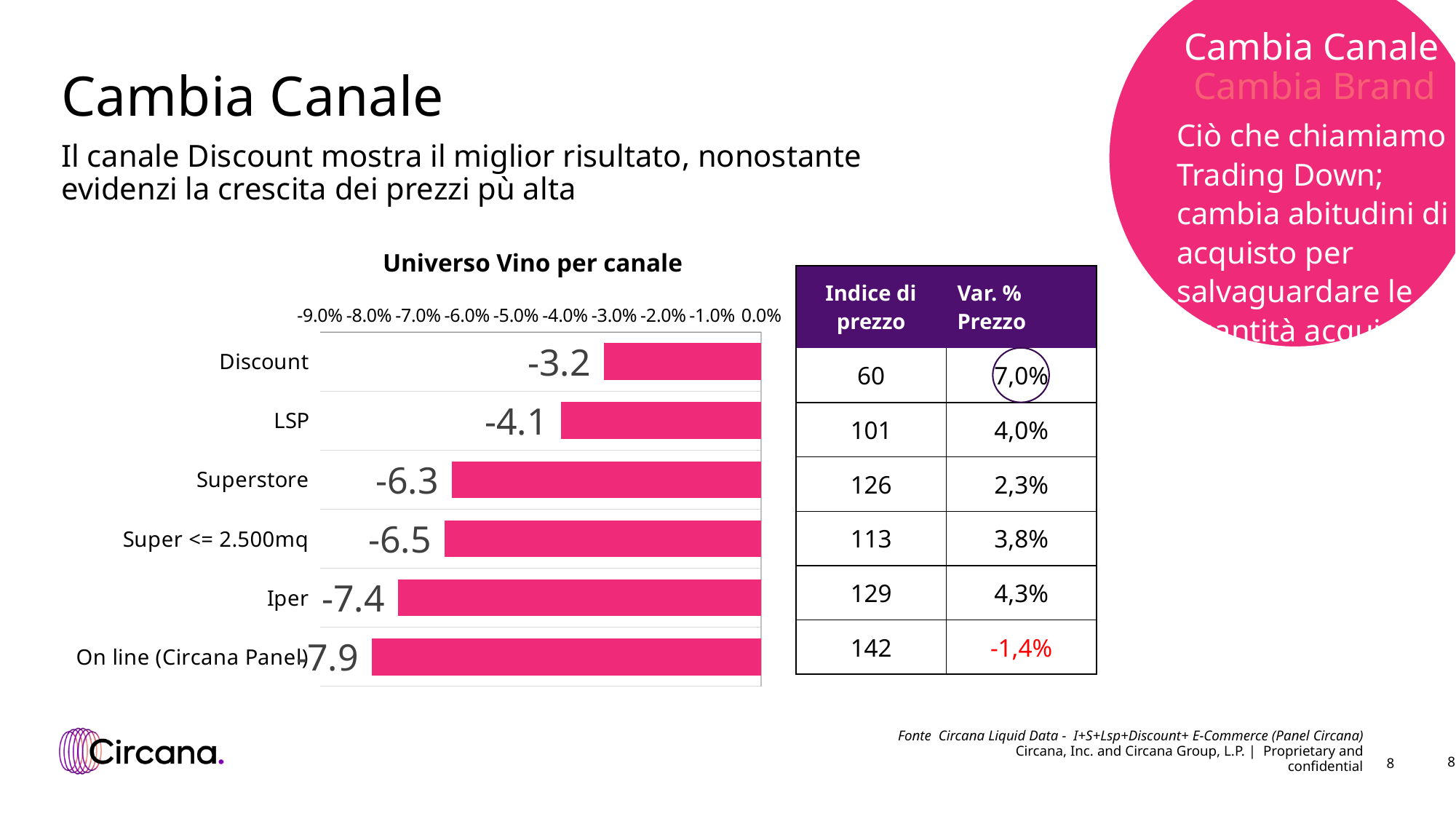
Which category has the highest (least negative) value in the Universo Vino per canale chart? Discount What is the difference between the values for LSP and Discount in the Universo Vino per canale chart? 0.9 What is the value for Iper in the Universo Vino per canale chart? -7.4 Which has the larger (less negative) value in the Universo Vino per canale chart, Superstore or Iper? Superstore What is the title of the chart on the slide? Universo Vino per canale What is the value for Super <= 2.500mq in the Universo Vino per canale chart? -6.5 Which category has the lowest (most negative) value in the Universo Vino per canale chart? On line (Circana Panel) How many categories are shown in the Universo Vino per canale chart? 6 What is the value for On line (Circana Panel) in the Universo Vino per canale chart? -7.9 What kind of chart is the Universo Vino per canale chart? Bar chart What is the value for Discount in the Universo Vino per canale chart? -3.2 Is the value for LSP in the Universo Vino per canale chart greater or less than -5.0%? greater